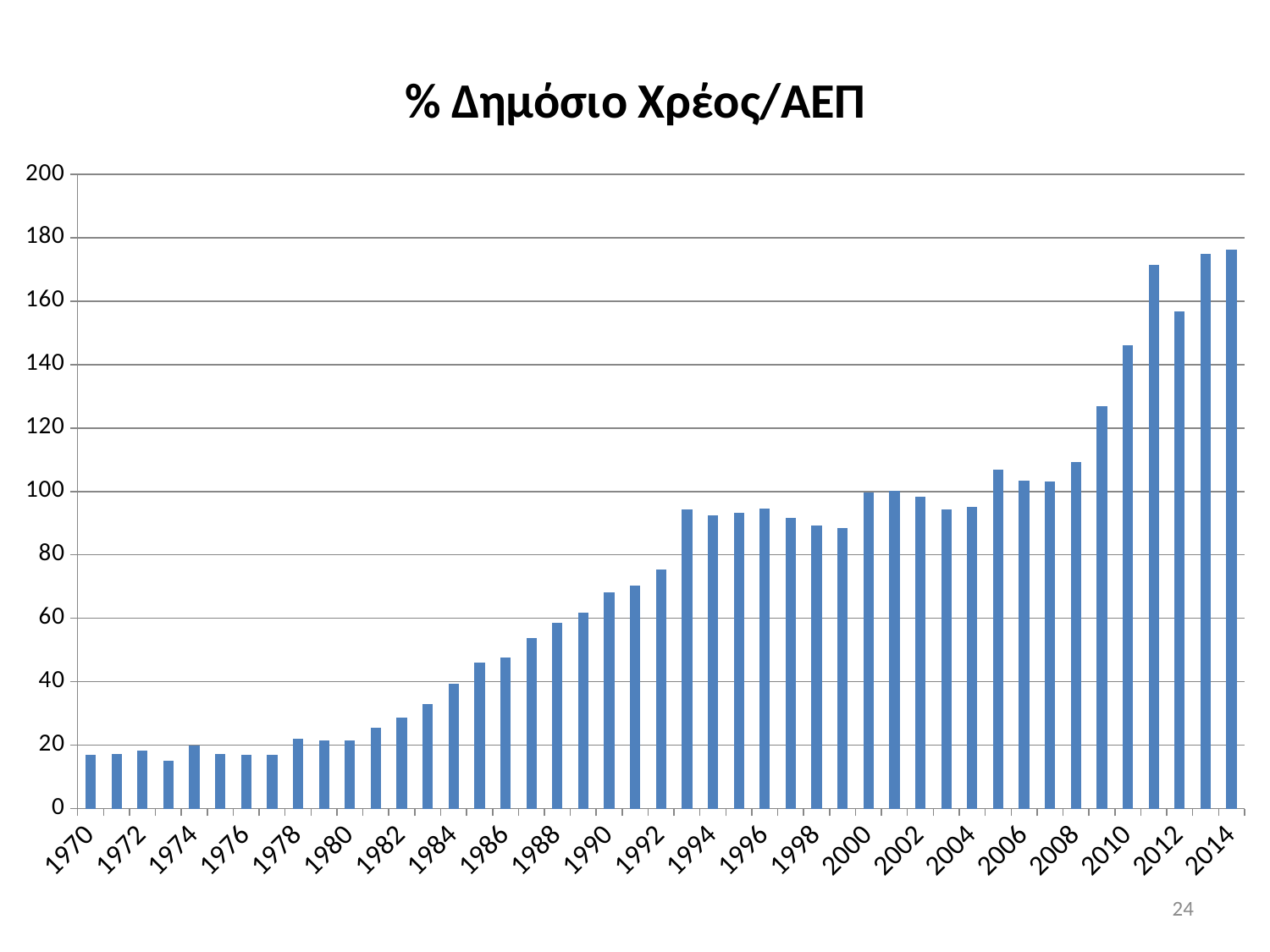
Is the value for 2010 greater or less than 140? greater Is the value for 1970 greater or less than 20? less Overall, do the values rise or fall from 1970 to 2014? rise Which year has the highest value in the chart? 2014 Is the value for 2009 greater or less than 120? greater Which year has the larger value, 2011 or 2012? 2011 What kind of chart is shown on the slide? bar chart Which year has the lowest value in the chart? 1973 What is the title of the chart? % Δημόσιο Χρέος/ΑΕΠ Which year has the larger value, 1980 or 1990? 1990 How many years (bars) are plotted in the chart? 45